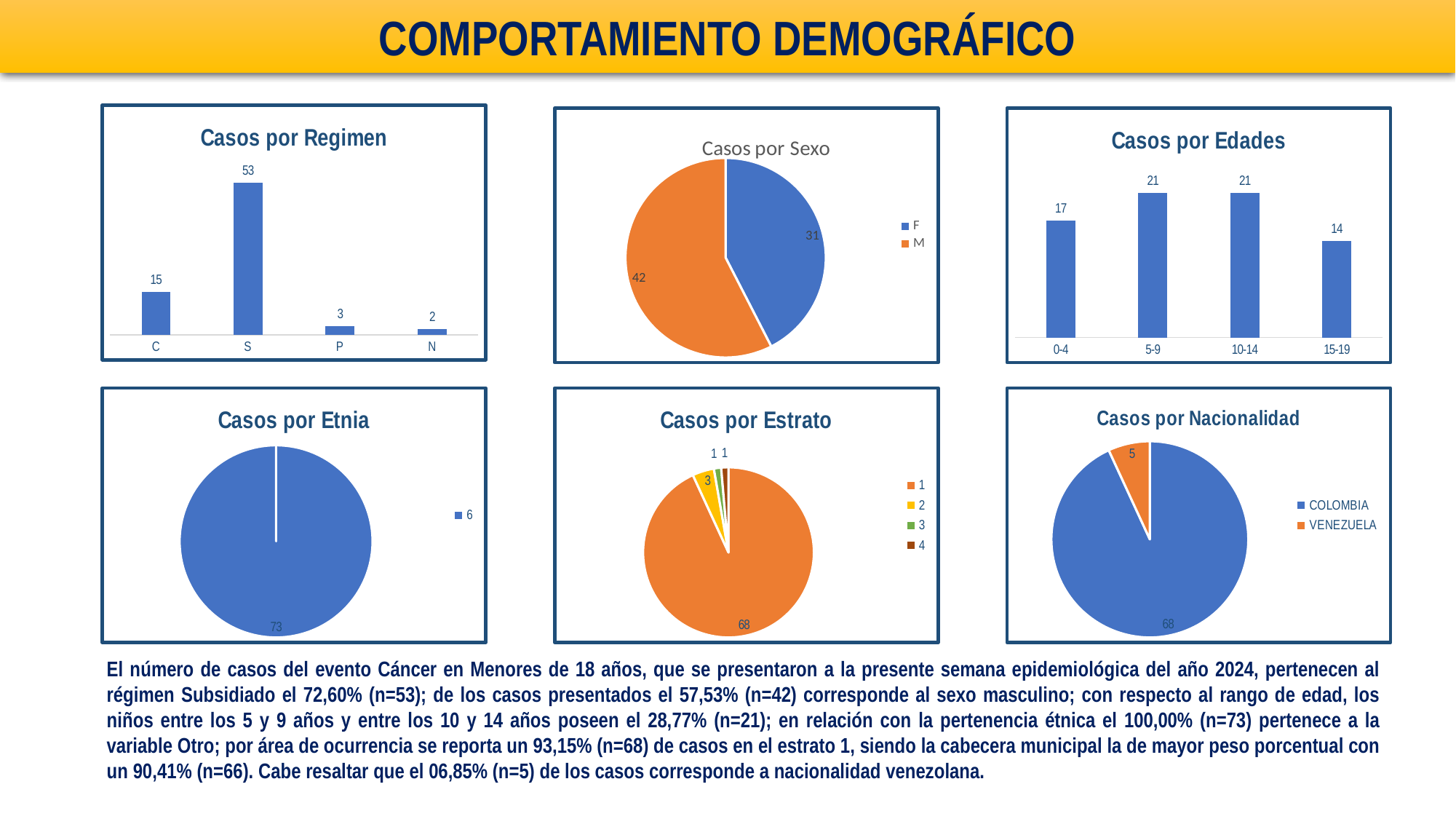
What kind of chart is 'Casos por Nacionalidad'? pie chart In the 'Casos por Nacionalidad' chart, what is the value for VENEZUELA? 5 How many categories are shown in the 'Casos por Edades' chart? 4 In the 'Casos por Edades' chart, what is the value for 15-19? 14 How many entries does the legend of the 'Casos por Estrato' chart list? 4 In the 'Casos por Regimen' chart, what is the difference between the values for S and C? 38 In the 'Casos por Regimen' chart, what is the value for S? 53 In the 'Casos por Regimen' chart, which category has the lowest value? N In the 'Casos por Estrato' chart, what is the value for slice 2? 3 In the 'Casos por Sexo' chart, what is the value for M? 42 In the 'Casos por Sexo' chart, which is larger, F or M? M What kind of chart is 'Casos por Edades'? bar chart